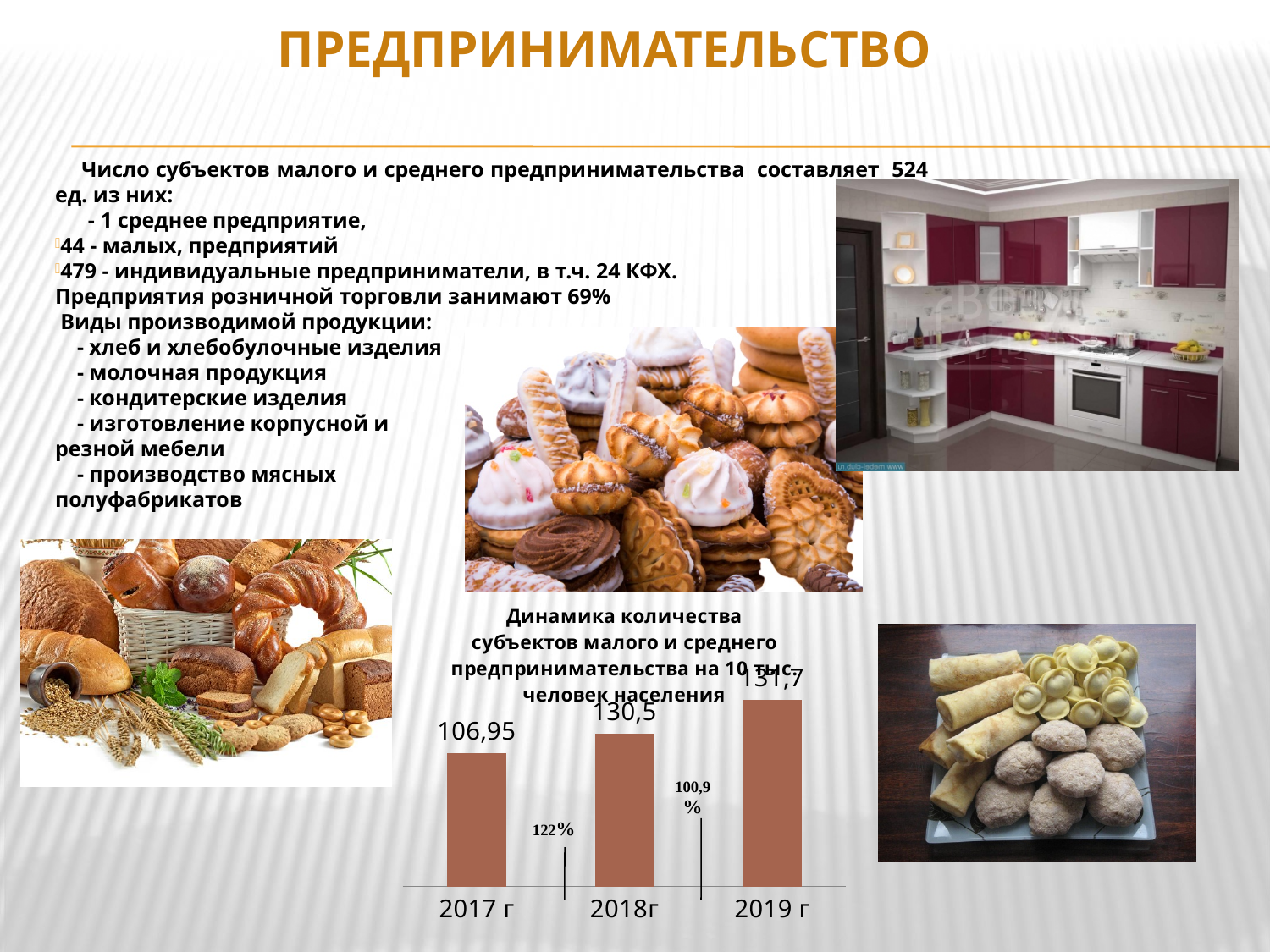
What is the value for 2017 г? 106,95 What percentage is annotated between the 2017 г and 2018г bars? 122% Do the values rise or fall from 2017 г to 2019 г? rise What is the difference between the values for 2019 г and 2018г? 1,2 What is the value for 2018г? 130,5 Which year has the highest value? 2019 г What is the difference between the values for 2018г and 2017 г? 23,55 What kind of chart is shown on the slide? bar chart Which year has the lowest value? 2017 г What is the value for 2019 г? 131,7 Which is larger, the value for 2017 г or the value for 2018г? 2018г How many years are shown on the chart? 3